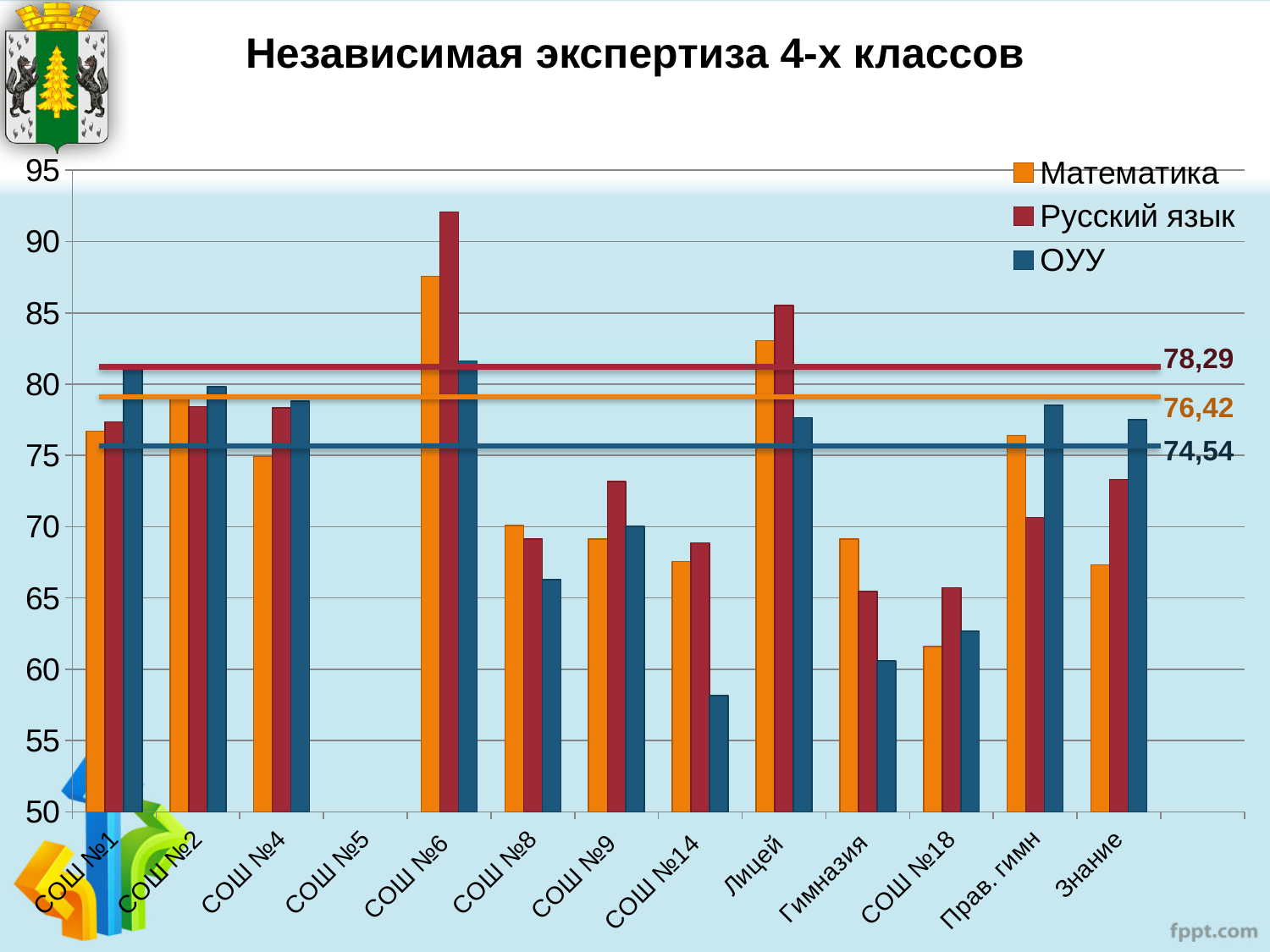
Is the ОУУ value for СОШ №14 greater or less than 60? less How many series does the legend list? 3 What is the title of the chart? Независимая экспертиза 4-х классов Which school has the highest Математика bar? СОШ №6 Which school has the lowest Математика bar? СОШ №18 How many school categories are labelled on the x axis? 13 Which is larger for СОШ №9: the Математика value or the Русский язык value? Русский язык Which school has the lowest ОУУ bar? СОШ №14 Is the Русский язык value for СОШ №6 greater or less than 90? greater What kind of chart is shown on the slide? bar chart What value is labelled on the red horizontal line across the chart? 78,29 Which school has the highest Русский язык bar? СОШ №6